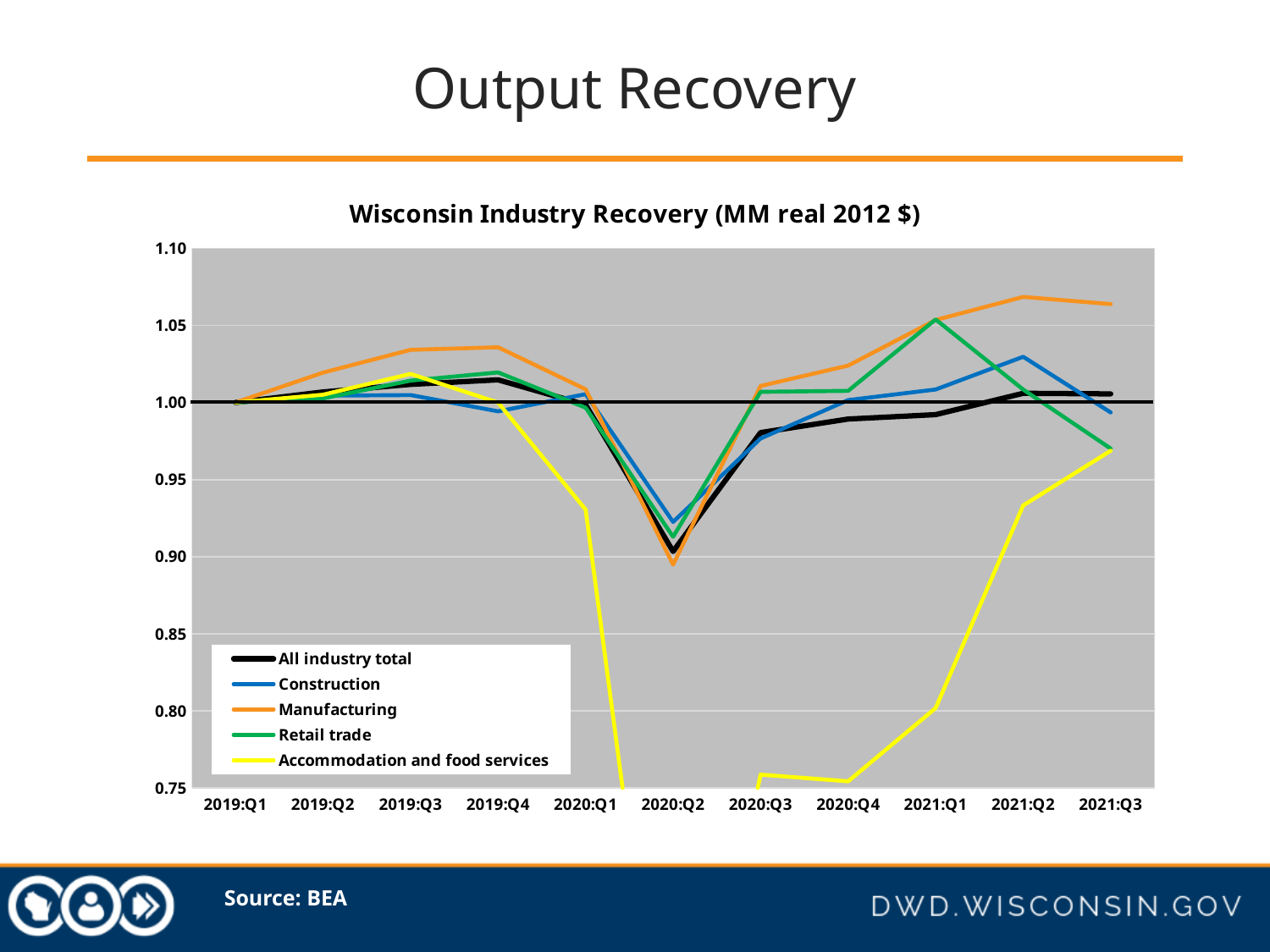
How many quarters are shown along the x axis? 11 Is the value for Accommodation and food services at 2021:Q2 greater or less than 0.95? less Does the Manufacturing series rise or fall from 2020:Q2 to 2021:Q2? Rise Which series has the lowest value at 2020:Q2? Accommodation and food services Which is larger at 2021:Q1, Manufacturing or Accommodation and food services? Manufacturing What is the title of the chart? Wisconsin Industry Recovery (MM real 2012 $) Is the value for Manufacturing at 2021:Q3 greater or less than 1.05? greater How many series does the legend list? 5 In which quarter does the All industry total series reach its lowest value? 2020:Q2 Which series has the highest value at 2021:Q3? Manufacturing Which series is shown in yellow in the legend? Accommodation and food services What kind of chart is shown on the slide? Line chart